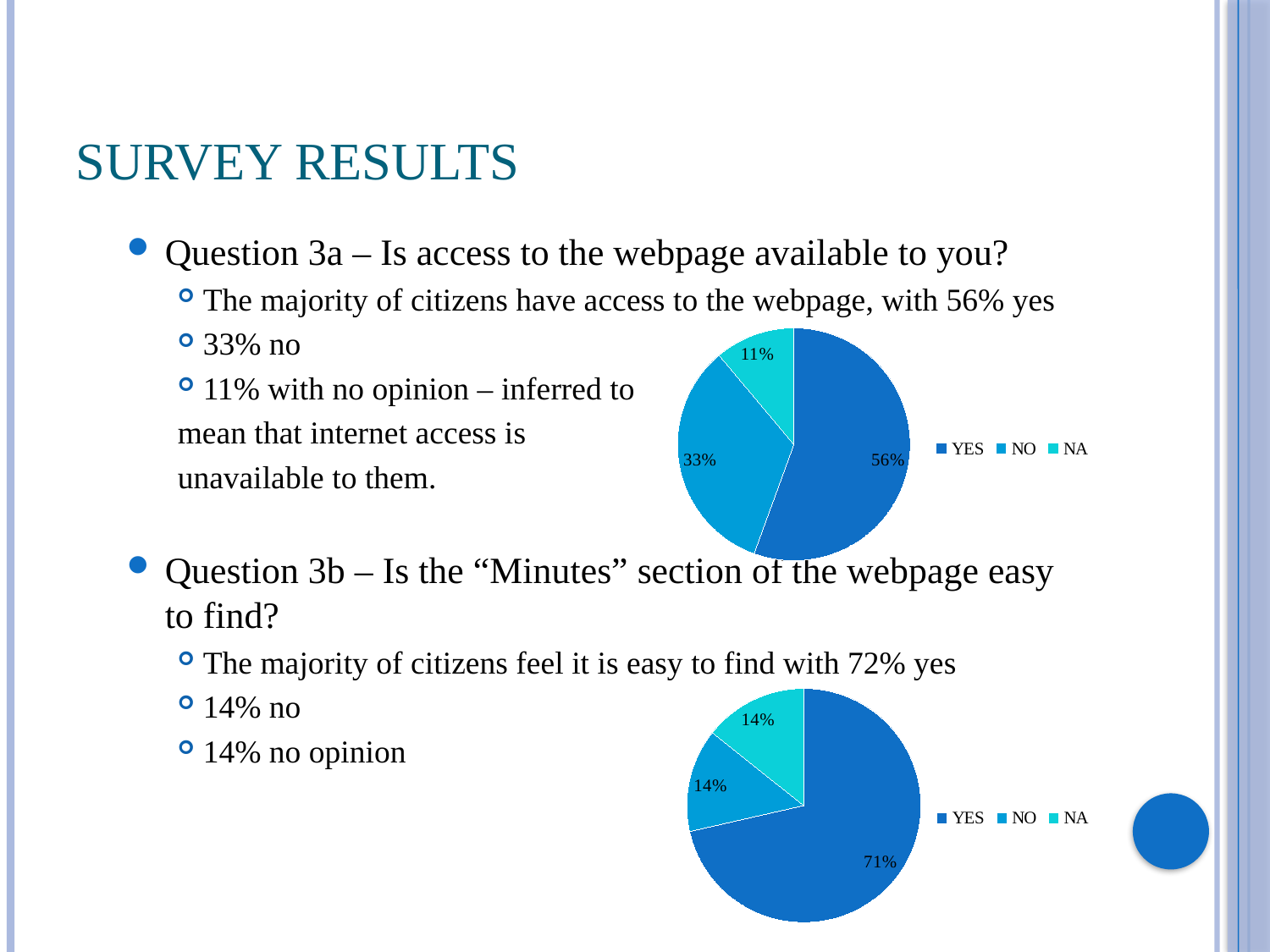
In the upper pie chart, what share is labelled for YES? 56% In the lower pie chart, what is the difference between the YES and NA shares? 57% In the lower pie chart, what share is labelled for NO? 14% In the upper pie chart, what share is labelled for NA? 11% How many entries does the legend of the lower pie chart list? 3 In the upper pie chart, which category has the largest slice? YES In the upper pie chart, what share is labelled for NO? 33% In the lower pie chart, what share is labelled for YES? 71% In the upper pie chart, which category has the smallest slice? NA What kind of chart is the upper chart on the slide? pie chart In the lower pie chart, which category has the largest slice? YES In the upper pie chart, what is the difference between the YES and NO shares? 23%